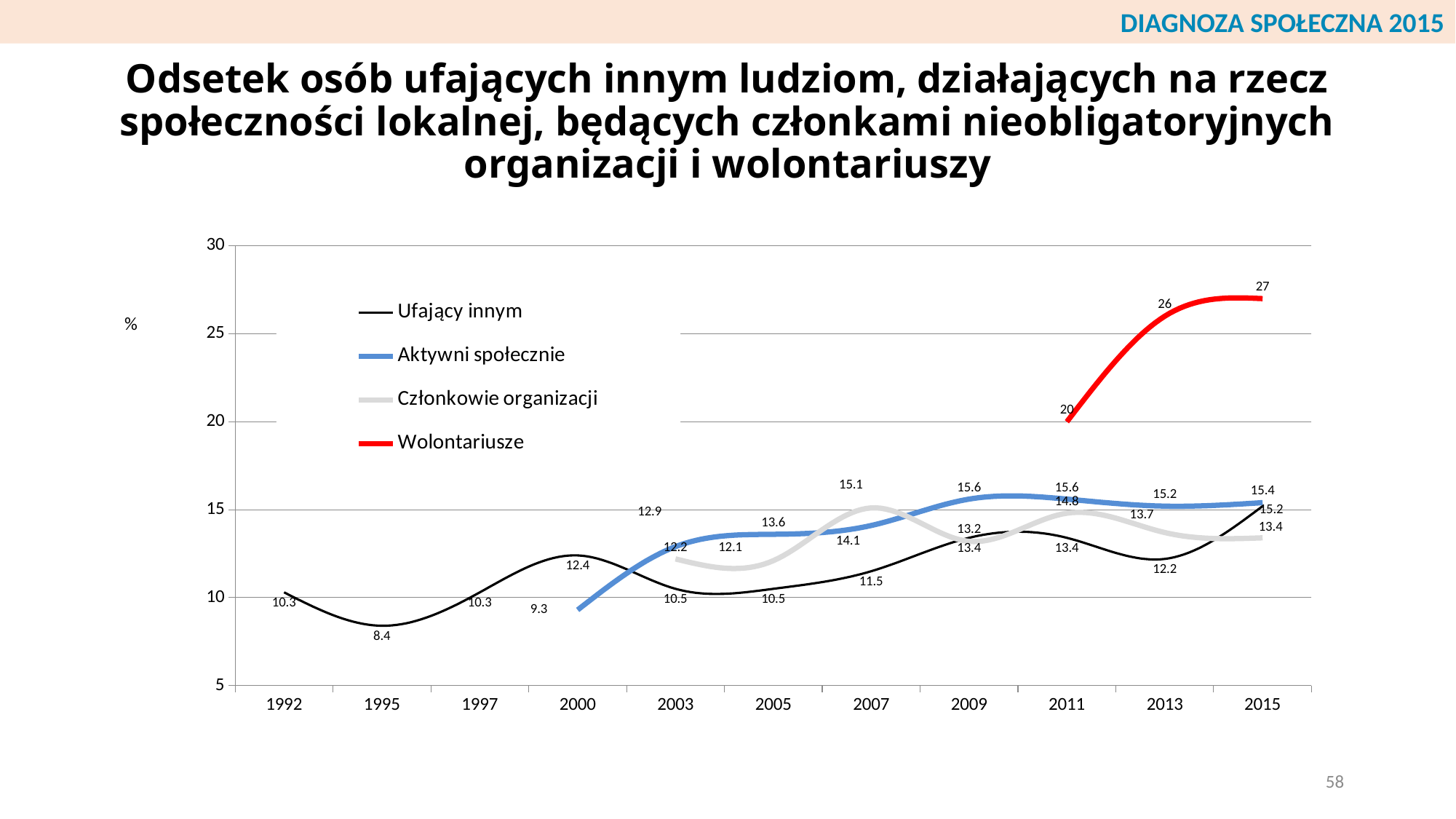
Does the Wolontariusze series rise or fall from 2011 to 2015? rise How many years are shown on the x axis? 11 What is the difference between the Wolontariusze values in 2015 and 2011? 7 What type of chart is shown on the slide? line chart What is the value for Wolontariusze in 2015? 27 What is the value for Aktywni społecznie in 2000? 9.3 What is the value for Wolontariusze in 2011? 20 What is the value for Ufający innym in 1995? 8.4 Which series has the highest value in 2015? Wolontariusze How many series does the legend list? 4 What is the value for Ufający innym in 2015? 15.2 In which year is the Ufający innym series at its lowest? 1995